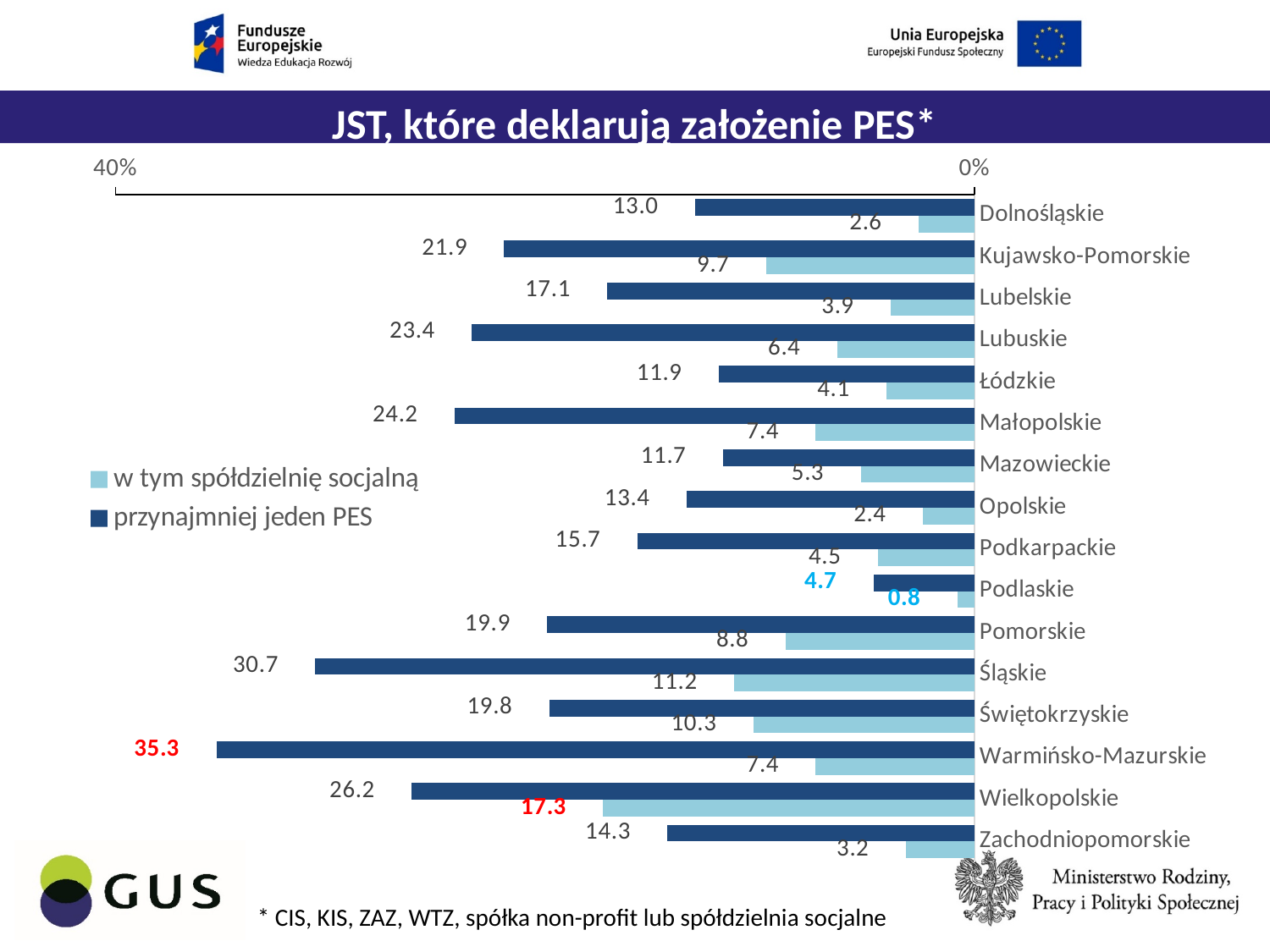
What is the difference between the 'przynajmniej jeden PES' value and the 'w tym spółdzielnię socjalną' value for Warmińsko-Mazurskie? 27.9 Which voivodeship has the lowest value for 'w tym spółdzielnię socjalną'? Podlaskie What is the value of 'w tym spółdzielnię socjalną' for Kujawsko-Pomorskie? 9.7 What is the value of 'przynajmniej jeden PES' for Śląskie? 30.7 What is the value of 'przynajmniej jeden PES' for Podlaskie? 4.7 How many voivodeships are shown on the chart? 16 What is the title of the chart? JST, które deklarują założenie PES* What type of chart is shown on the slide? Bar chart Which voivodeship has the highest value for 'przynajmniej jeden PES'? Warmińsko-Mazurskie How many series does the legend list? 2 What is the value of 'w tym spółdzielnię socjalną' for Wielkopolskie? 17.3 Which is larger: the 'przynajmniej jeden PES' value for Lubuskie or for Małopolskie? Małopolskie